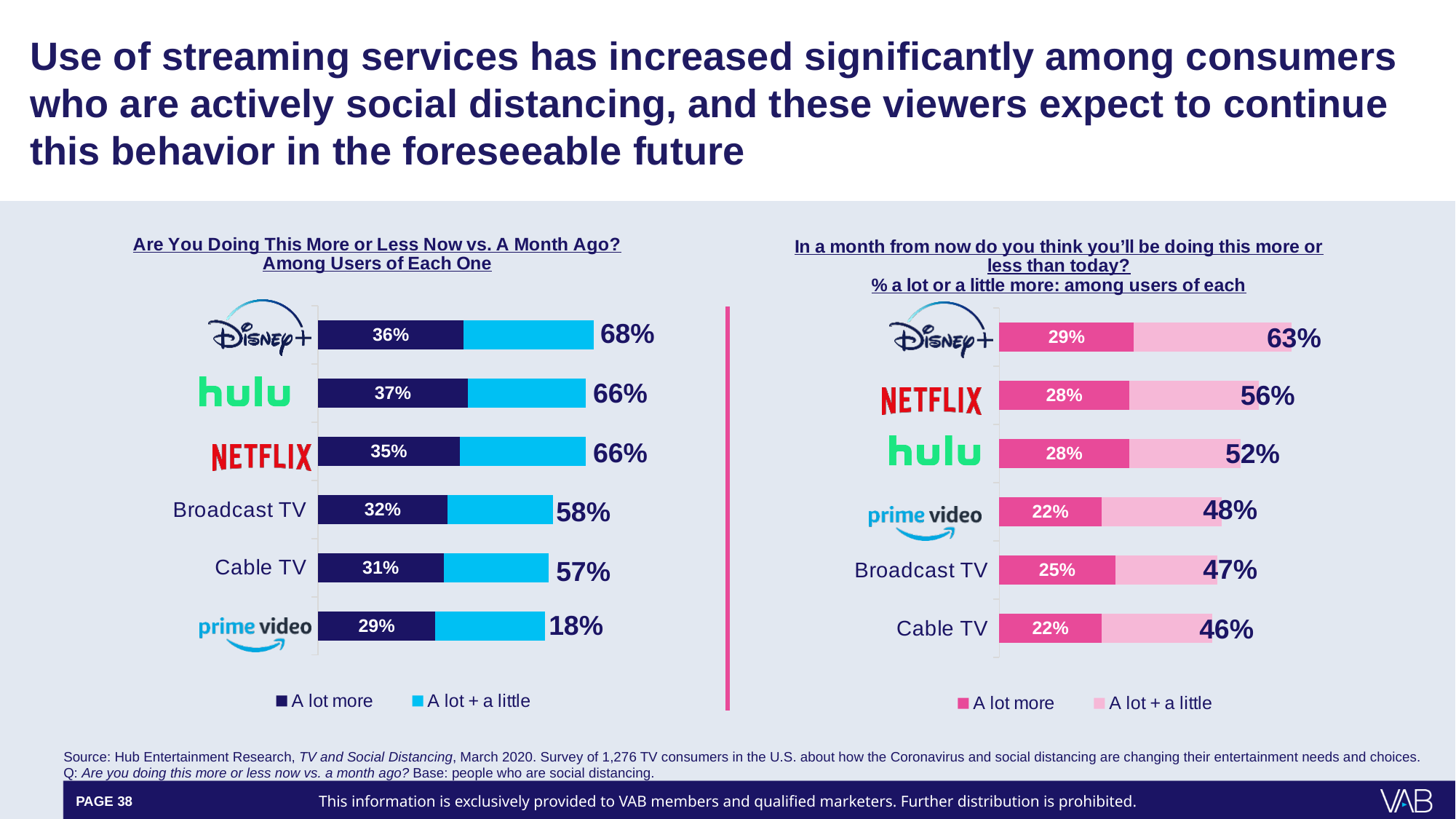
In the left chart ("Are You Doing This More or Less Now vs. A Month Ago?"), what is the "A lot more" value for Cable TV? 31% In the right chart ("In a month from now..."), which category has the highest "A lot more" value? Disney+ In the right chart ("In a month from now..."), which category has the lowest "A lot + a little" value? Cable TV In the left chart ("Are You Doing This More or Less Now vs. A Month Ago?"), what is the "A lot + a little" value for Disney+? 68% In the left chart ("Are You Doing This More or Less Now vs. A Month Ago?"), what is the difference between the "A lot + a little" values for Disney+ and Broadcast TV? 10% How many series does the legend of the left chart list? 2 In the right chart ("In a month from now..."), what is the "A lot more" value for Broadcast TV? 25% In the left chart ("Are You Doing This More or Less Now vs. A Month Ago?"), which category has the highest "A lot more" value? Hulu How many categories are shown in the right chart ("In a month from now...")? 6 In the right chart ("In a month from now..."), is the "A lot + a little" value larger for Hulu or for Prime Video? Hulu In the right chart ("In a month from now..."), what is the "A lot + a little" value for Netflix? 56% In the left chart ("Are You Doing This More or Less Now vs. A Month Ago?"), what is the "A lot more" value for Hulu? 37%